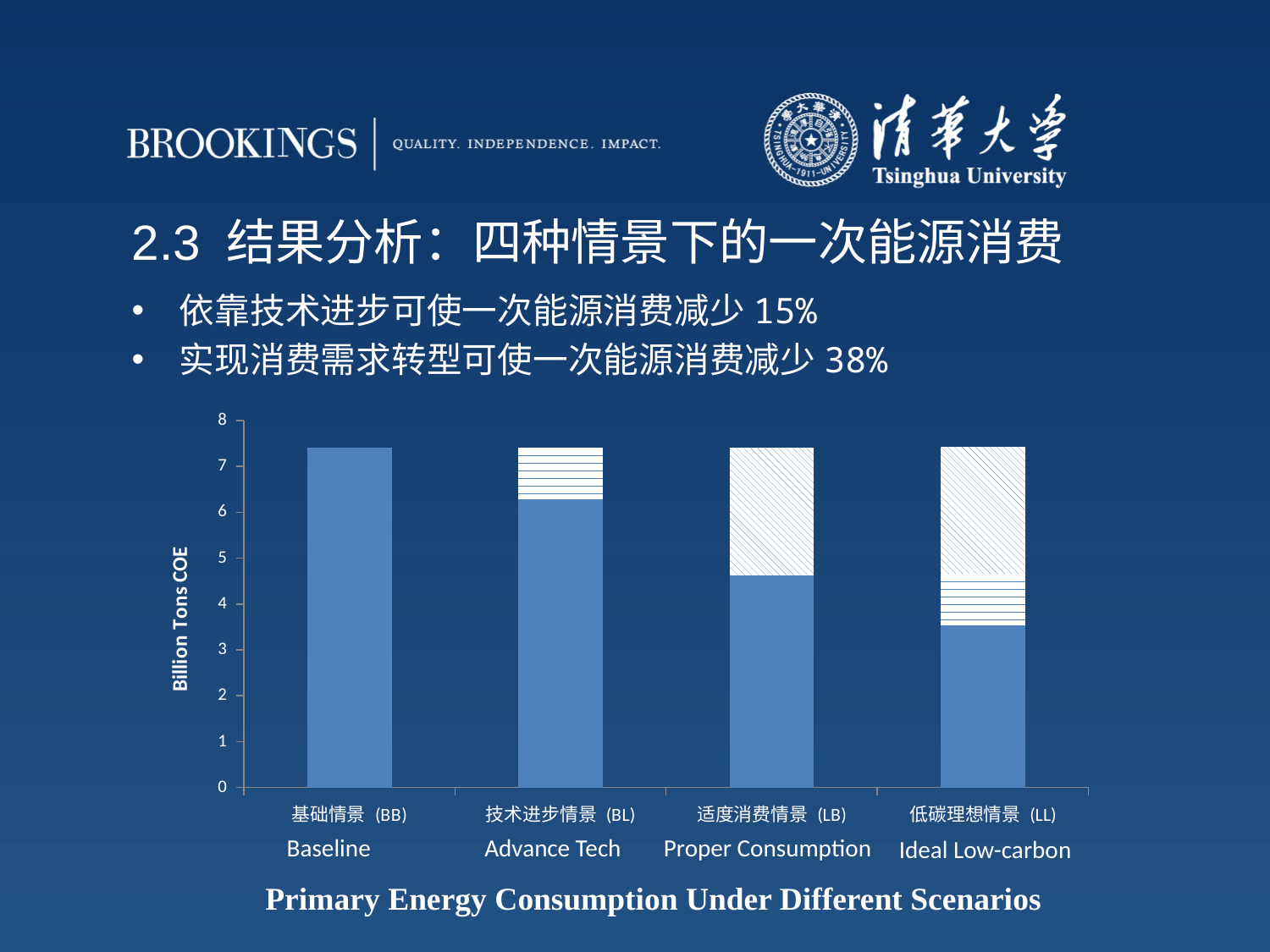
What is the label of the vertical axis of the chart? Billion Tons COE What kind of chart is shown on the slide? bar chart Is the solid (bottom) portion of the Ideal Low-carbon bar greater or less than 4? less How many scenarios (categories) are shown on the x axis of the chart? 4 What is the highest value shown on the vertical axis of the chart? 8 Is the solid (bottom) portion of the Advance Tech bar greater or less than 6? greater Which is larger, the solid portion of the Baseline bar or the solid portion of the Ideal Low-carbon bar? Baseline Is the solid (bottom) portion of the Proper Consumption bar greater or less than 5? less What is the title of the chart? Primary Energy Consumption Under Different Scenarios Does the solid (bottom) portion of the bars rise or fall from Baseline to Ideal Low-carbon along the x axis? fall Which scenario has the smallest solid (bottom) portion of its bar? Ideal Low-carbon